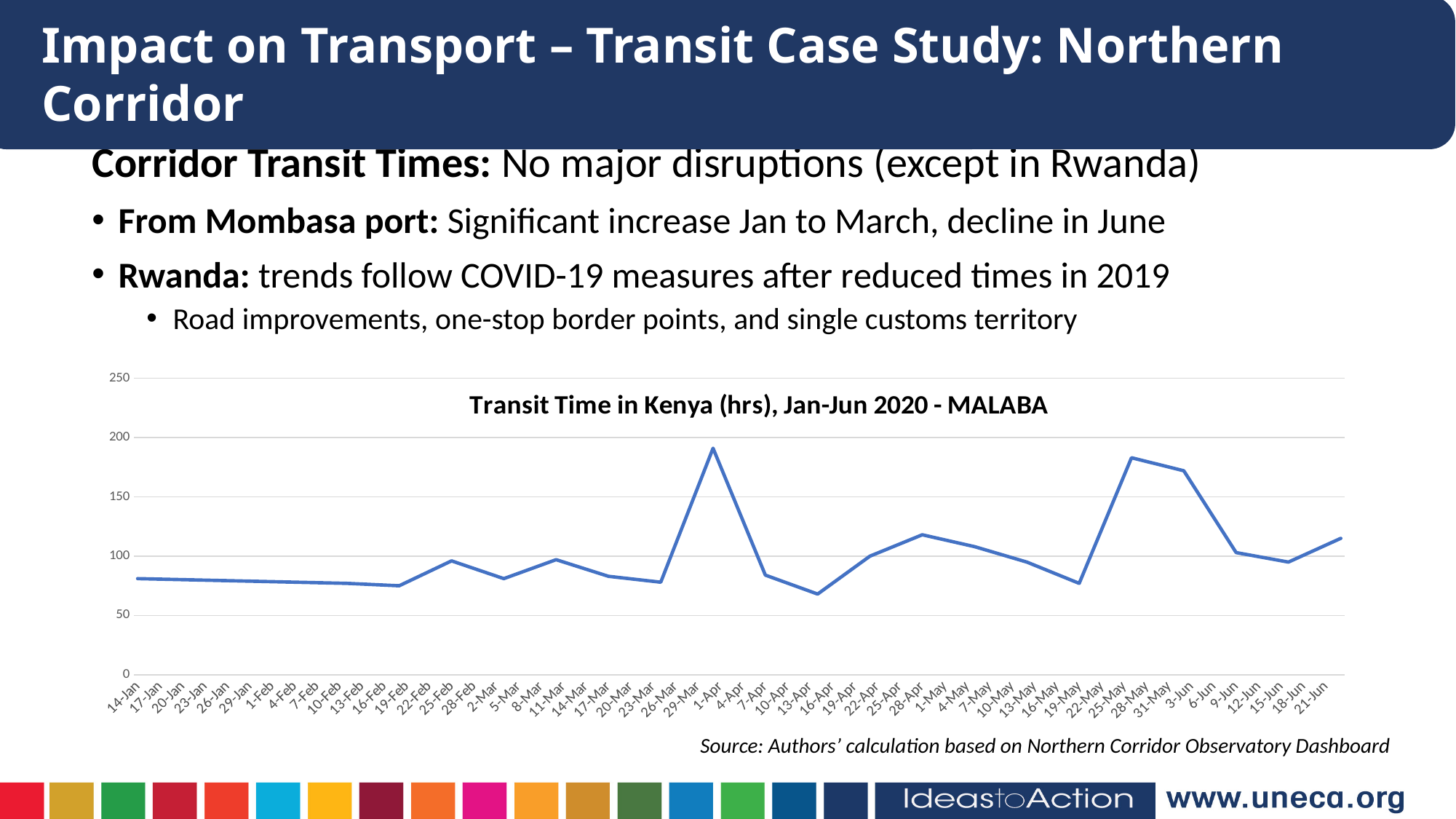
Which has the higher transit time, 19-May or 25-May? 25-May Which has the higher transit time, 1-Apr or 13-Apr? 1-Apr What is the title of the chart? Transit Time in Kenya (hrs), Jan-Jun 2020 - MALABA Is the transit time value at 14-Jan greater or less than 100? less Is the transit time value at 13-Apr greater or less than 100? less Is the transit time value at 28-Apr greater or less than 100? greater What kind of chart is shown on the slide? line chart Does the transit time rise or fall between 1-Apr and 13-Apr? fall How many data series (lines) are plotted on the chart? 1 What is the highest value shown on the vertical axis? 250